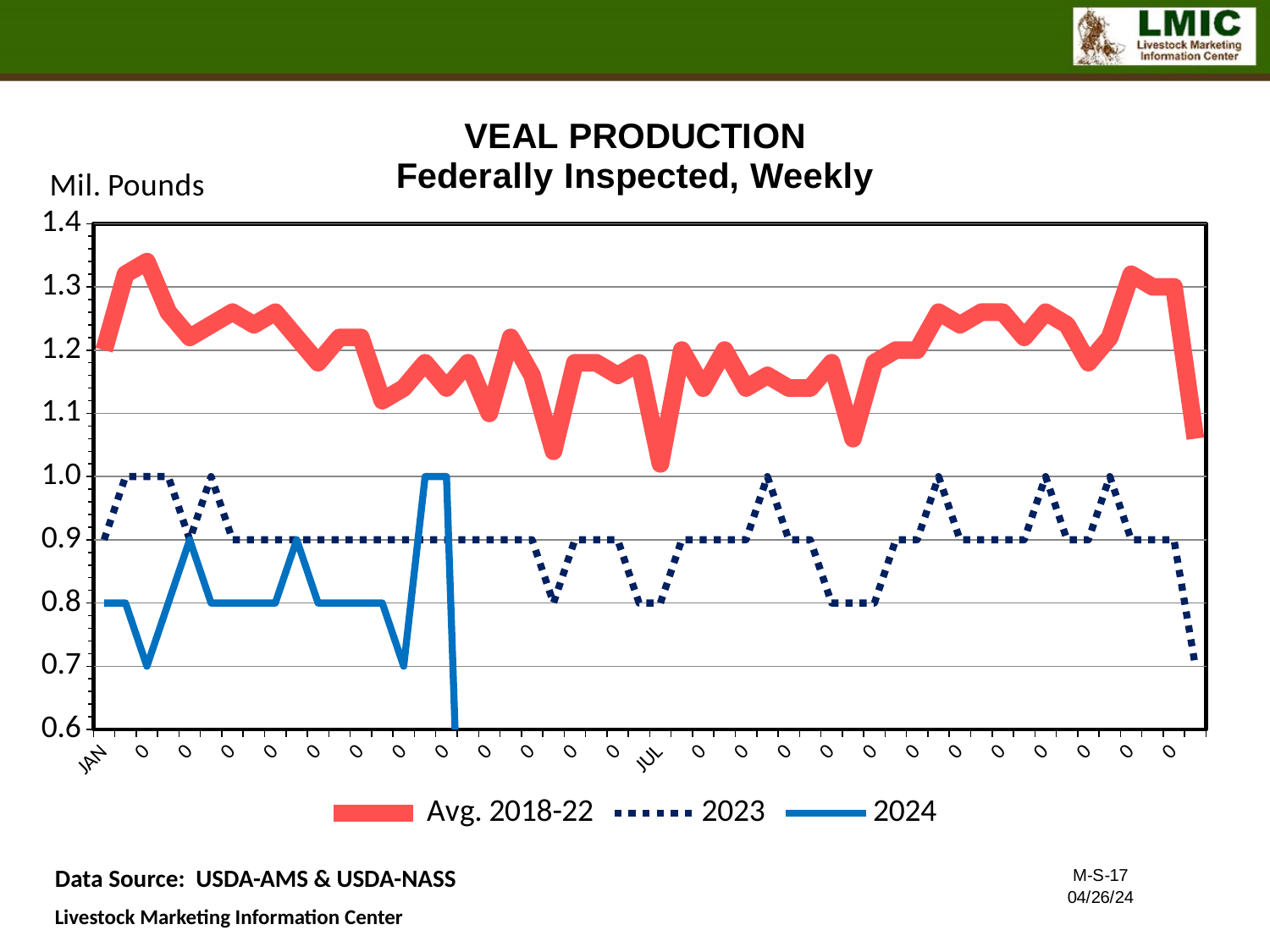
What is the value of the 2023 series at the first week (JAN)? 0.9 What is the highest value reached by the 2023 series? 1.0 At JUL, which is larger: the Avg. 2018-22 value or the 2023 value? Avg. 2018-22 What is the value of the 2024 series at the first week (JAN)? 0.8 What is the lowest value reached by the 2023 series? 0.7 What is the title of the chart? VEAL PRODUCTION Federally Inspected, Weekly What is the highest value reached by the 2024 series? 1.0 Which series has the highest values across the whole year? Avg. 2018-22 What unit is shown on the y axis of the chart? Mil. Pounds Is the Avg. 2018-22 value at JAN greater or less than 1.1? greater How many series does the legend list? 3 What kind of chart is shown on the slide? line chart